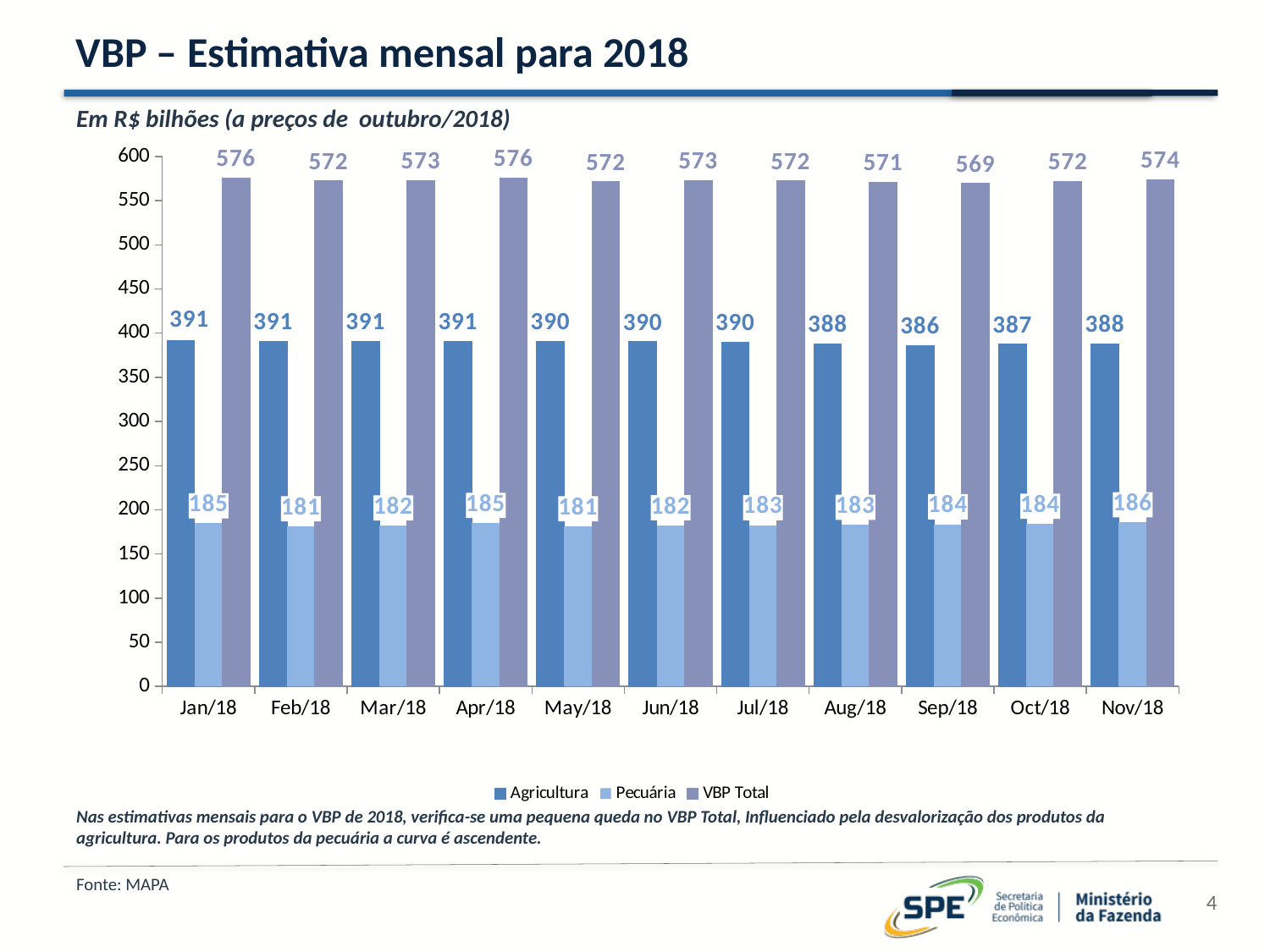
What is the value of Pecuária for Nov/18? 186 What is the value of VBP Total for Jan/18? 576 Does the Agricultura series rise or fall overall from Jan/18 to Nov/18? fall How many months are shown on the x axis? 11 How many series does the legend list? 3 In which month is Pecuária highest? Nov/18 What kind of chart is shown on the slide? bar chart Is the value for Pecuária in Feb/18 greater or less than 200? less In which month is VBP Total lowest? Sep/18 What is the difference between VBP Total in Jan/18 and VBP Total in Nov/18? 2 What is the value of Agricultura for Sep/18? 386 Which is larger: Agricultura in Jan/18 or Agricultura in Sep/18? Agricultura in Jan/18